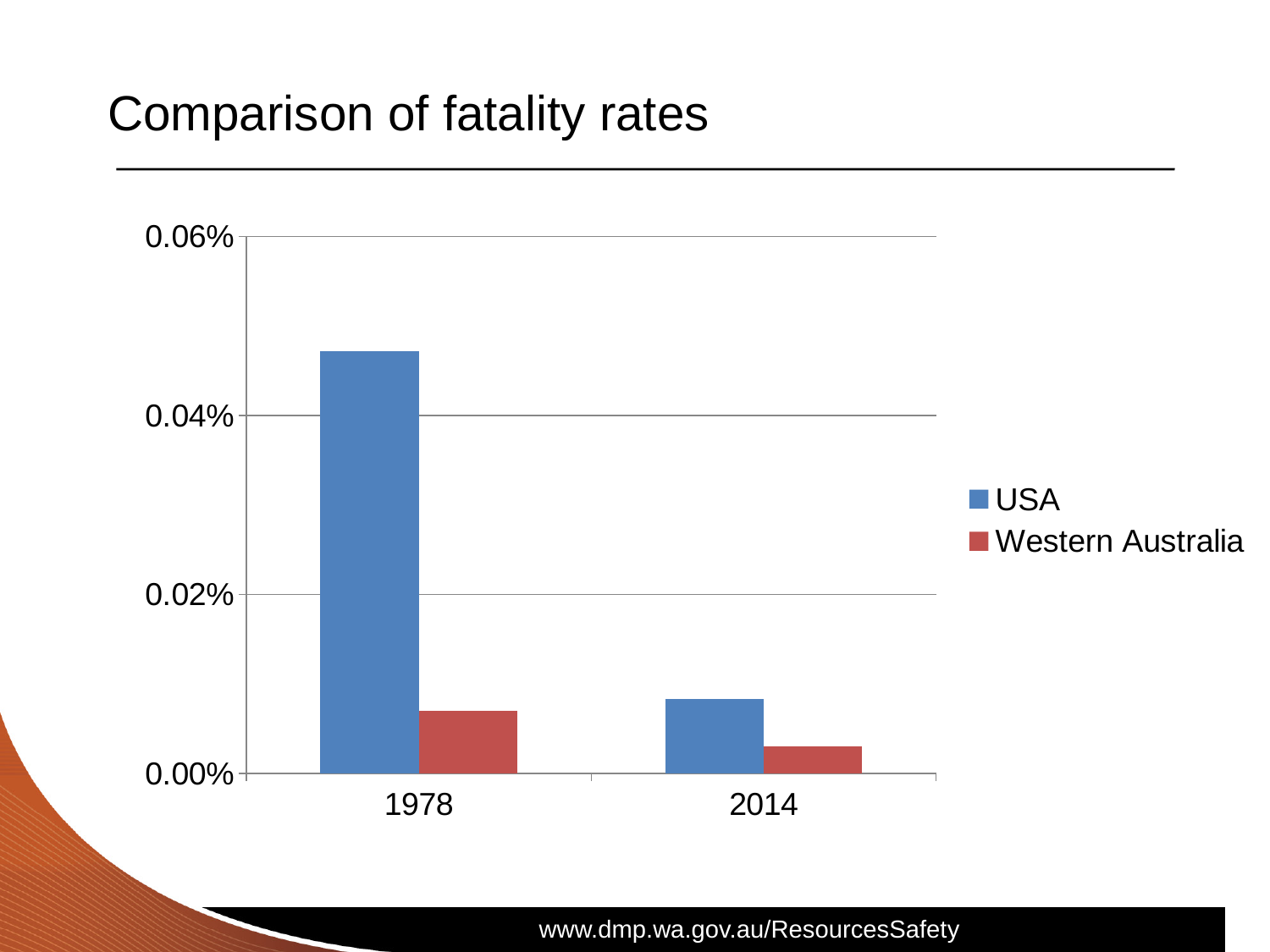
How many year categories are shown on the x axis? 2 Is the USA value for 1978 greater or less than 0.04%? greater Is the Western Australia value for 1978 greater or less than 0.02%? less How many series does the legend list? 2 In 1978, which is larger: the USA value or the Western Australia value? USA Is the USA value for 2014 greater or less than 0.02%? less What is the title of the chart on the slide? Comparison of fatality rates Which series has the highest bar on the chart? USA What kind of chart is shown on the slide? bar chart Which colour represents Western Australia in the legend? red Does the USA fatality rate rise or fall from 1978 to 2014? fall Which bar is the lowest on the chart? Western Australia in 2014